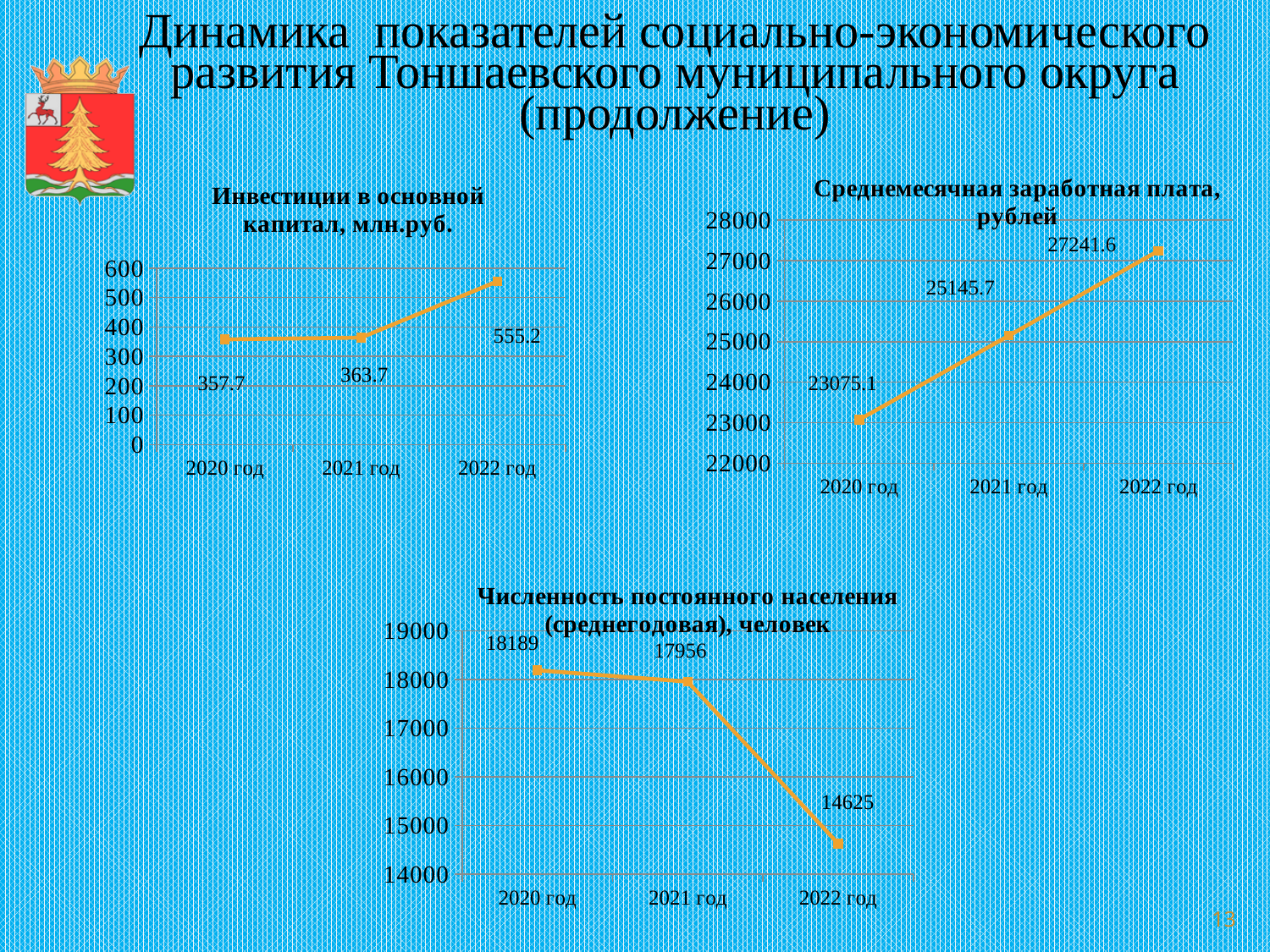
On the chart 'Инвестиции в основной капитал, млн.руб.', what is the difference between the 2022 год and 2021 год values? 191.5 On the chart 'Инвестиции в основной капитал, млн.руб.', what is the value for 2020 год? 357.7 On the chart 'Численность постоянного населения (среднегодовая), человек', what is the difference between the 2020 год and 2021 год values? 233 On the chart 'Численность постоянного населения (среднегодовая), человек', which is larger, the value for 2021 год or 2022 год? 2021 год On the chart 'Инвестиции в основной капитал, млн.руб.', what is the value for 2022 год? 555.2 On the chart 'Численность постоянного населения (среднегодовая), человек', which year has the lowest value? 2022 год On the chart 'Среднемесячная заработная плата, рублей', what is the value for 2021 год? 25145.7 On the chart 'Среднемесячная заработная плата, рублей', which year has the highest value? 2022 год On the chart 'Численность постоянного населения (среднегодовая), человек', what is the value for 2022 год? 14625 How many data points are plotted on the chart 'Инвестиции в основной капитал, млн.руб.'? 3 What kind of chart is 'Среднемесячная заработная плата, рублей'? line chart On the chart 'Среднемесячная заработная плата, рублей', do the values rise or fall from 2020 год to 2022 год? rise